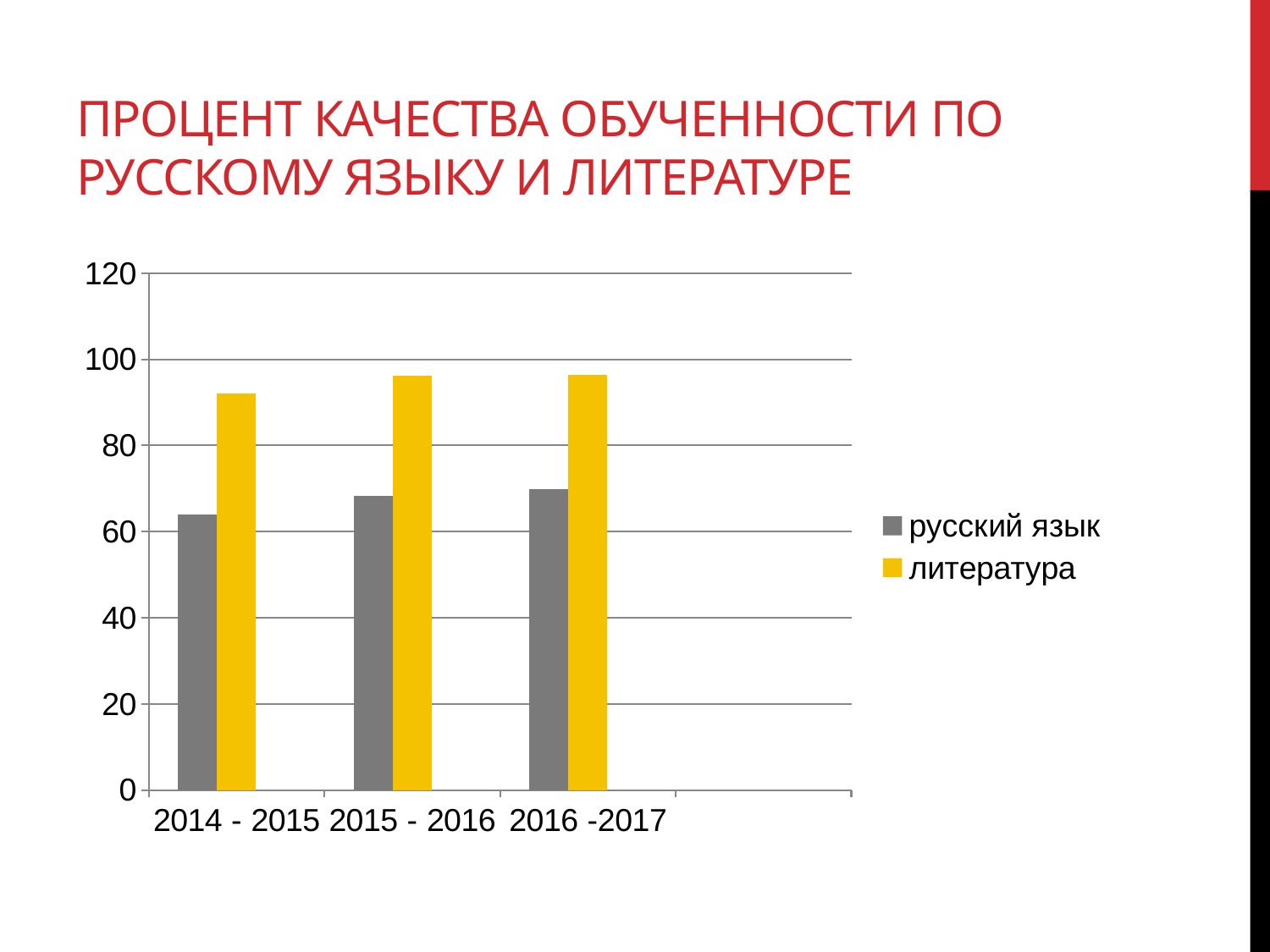
Is the value for русский язык in 2016 -2017 greater or less than 80? less What is the title of the slide? ПРОЦЕНТ КАЧЕСТВА ОБУЧЕННОСТИ ПО РУССКОМУ ЯЗЫКУ И ЛИТЕРАТУРЕ Which series does the yellow bar represent? литература Do the values for русский язык rise or fall from 2014 - 2015 to 2016 -2017? rise In which year is the value for русский язык the lowest? 2014 - 2015 How many series does the legend list? 2 What kind of chart is shown on the slide? bar chart Is the value for литература in 2014 - 2015 greater or less than 80? greater How many academic years are shown on the x axis? 3 Is the value for литература in 2015 - 2016 greater or less than 100? less In 2014 - 2015, which is larger: русский язык or литература? литература